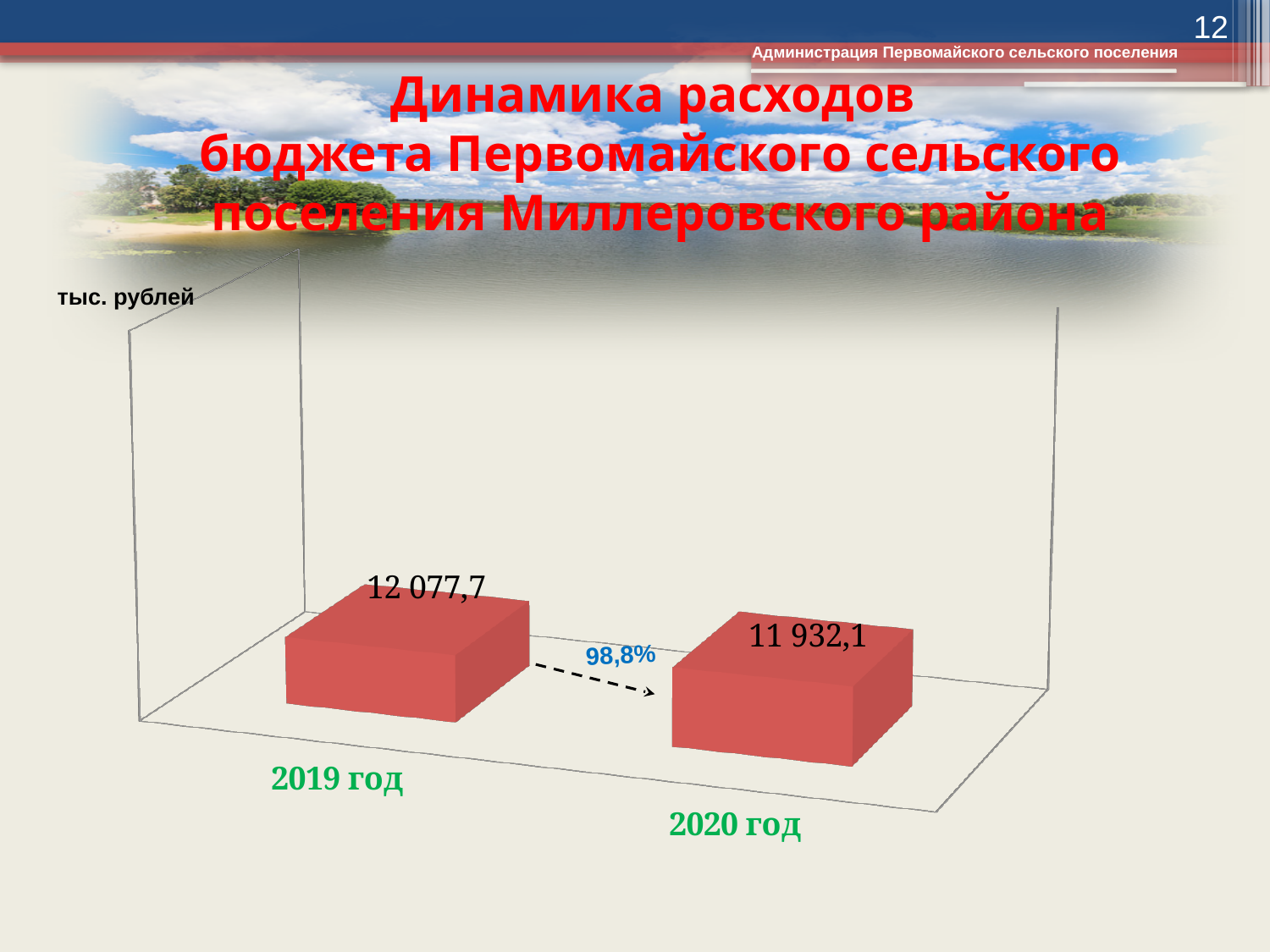
What is the value for 2020 год? 11 932,1 What is the value for 2019 год? 12 077,7 Which year has the higher value? 2019 год What percentage is shown on the arrow between the two bars? 98,8% Do the values rise or fall from 2019 год to 2020 год? fall Which year has the lower value? 2020 год How many bars are shown in the chart? 2 What kind of chart is shown on the slide? bar chart Is the value for 2019 год larger or smaller than the value for 2020 год? larger What unit of measurement is indicated on the chart? тыс. рублей What is the difference between the values for 2019 год and 2020 год? 145,6